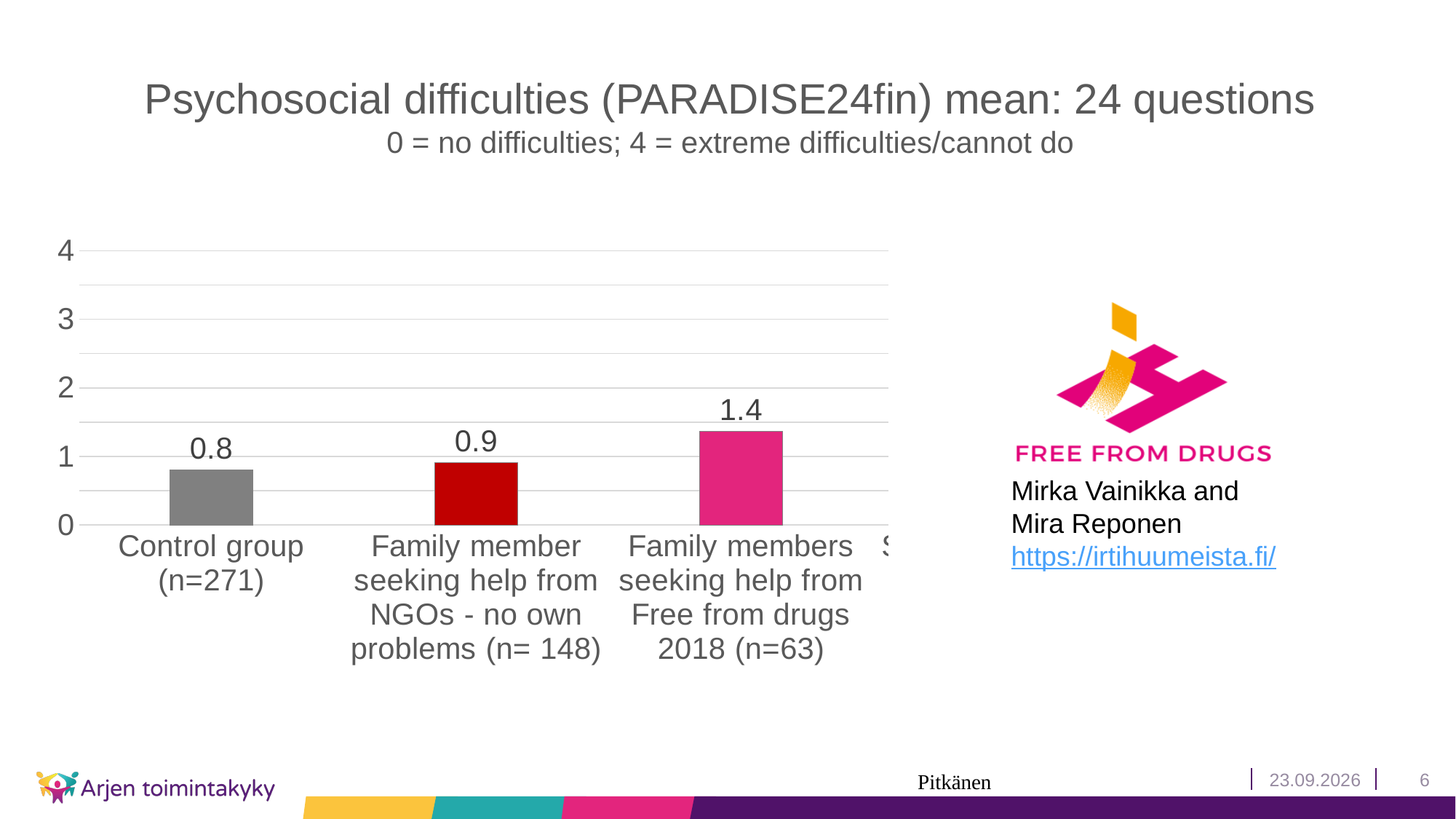
What is the difference between the NGOs group and the Control group? 0.1 What is the maximum value shown on the vertical axis? 4 What is the mean psychosocial difficulties score for the Control group (n=271)? 0.8 What kind of chart is shown on the slide? bar chart Is the value for the Control group greater or less than 1? less Which of the labelled groups has the highest mean score? Family members seeking help from Free from drugs 2018 (n=63) What is the value for Family members seeking help from Free from drugs 2018 (n=63)? 1.4 Which is larger, the value for the Control group or the value for Family members seeking help from Free from drugs 2018? Family members seeking help from Free from drugs 2018 Is the value for Family members seeking help from Free from drugs 2018 greater or less than 1? greater Which of the labelled groups has the lowest mean score? Control group (n=271) What is the value for Family member seeking help from NGOs - no own problems (n= 148)? 0.9 What is the difference between the Free from drugs 2018 group and the Control group? 0.6